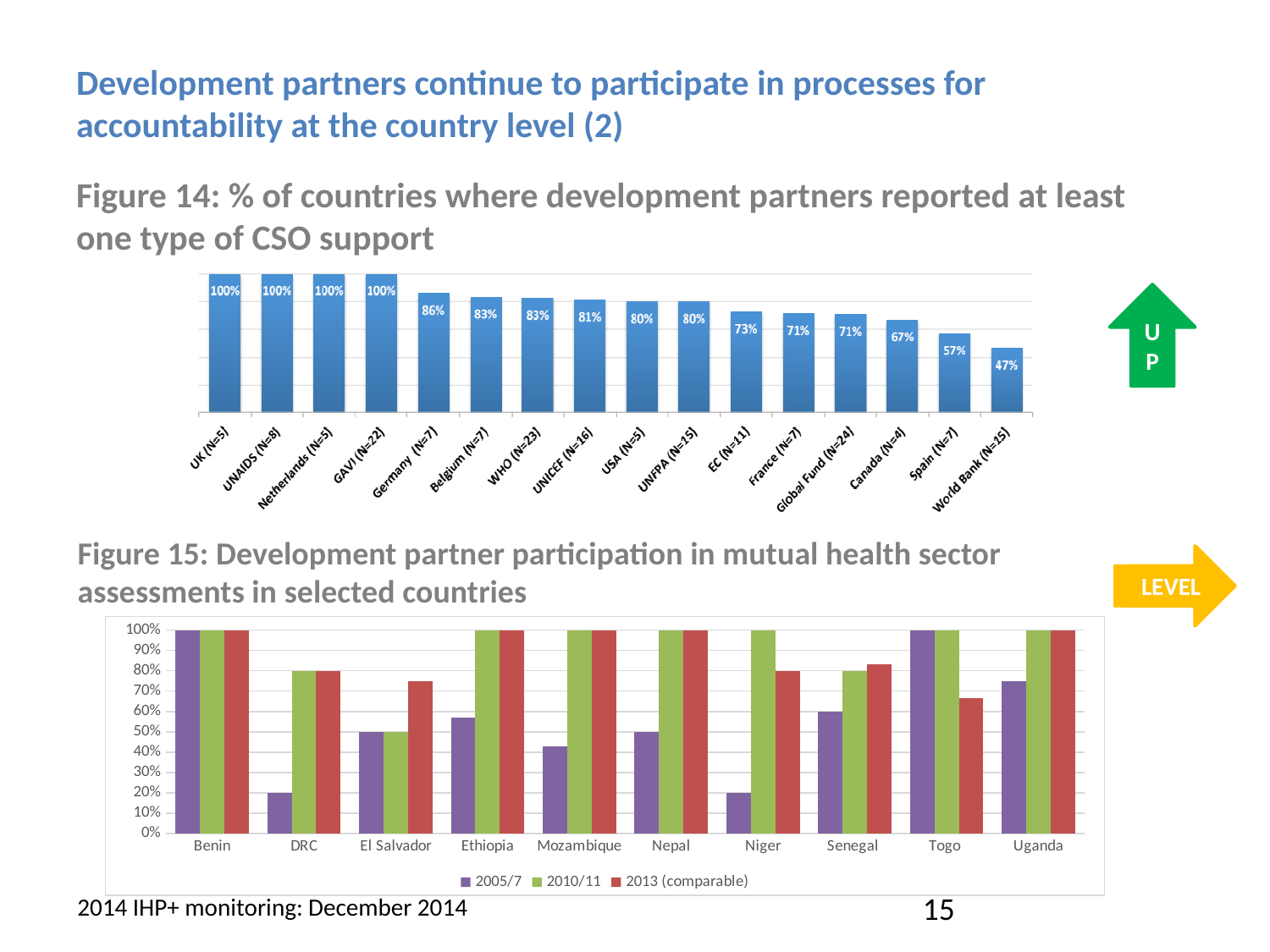
In Figure 14, how many development partners are shown? 16 In Figure 15, is the 2005/7 value for Niger greater or less than 50%? less In Figure 14, what is the value for World Bank (N=15)? 47% In Figure 15, how many series does the legend list? 3 In Figure 14, do the values generally rise or fall from left to right? fall In Figure 14, what is the value for Germany (N=7)? 86% In Figure 15, is the 2013 (comparable) value for Togo greater or less than 80%? less What kind of chart is Figure 15? bar chart In Figure 14, which is larger, the value for EC (N=11) or the value for France (N=7)? EC (N=11) In Figure 14, what is the difference between the values for Canada (N=4) and Spain (N=7)? 10% In Figure 14, which development partner has the lowest value? World Bank (N=15) In Figure 15, how many countries are shown on the x axis? 10